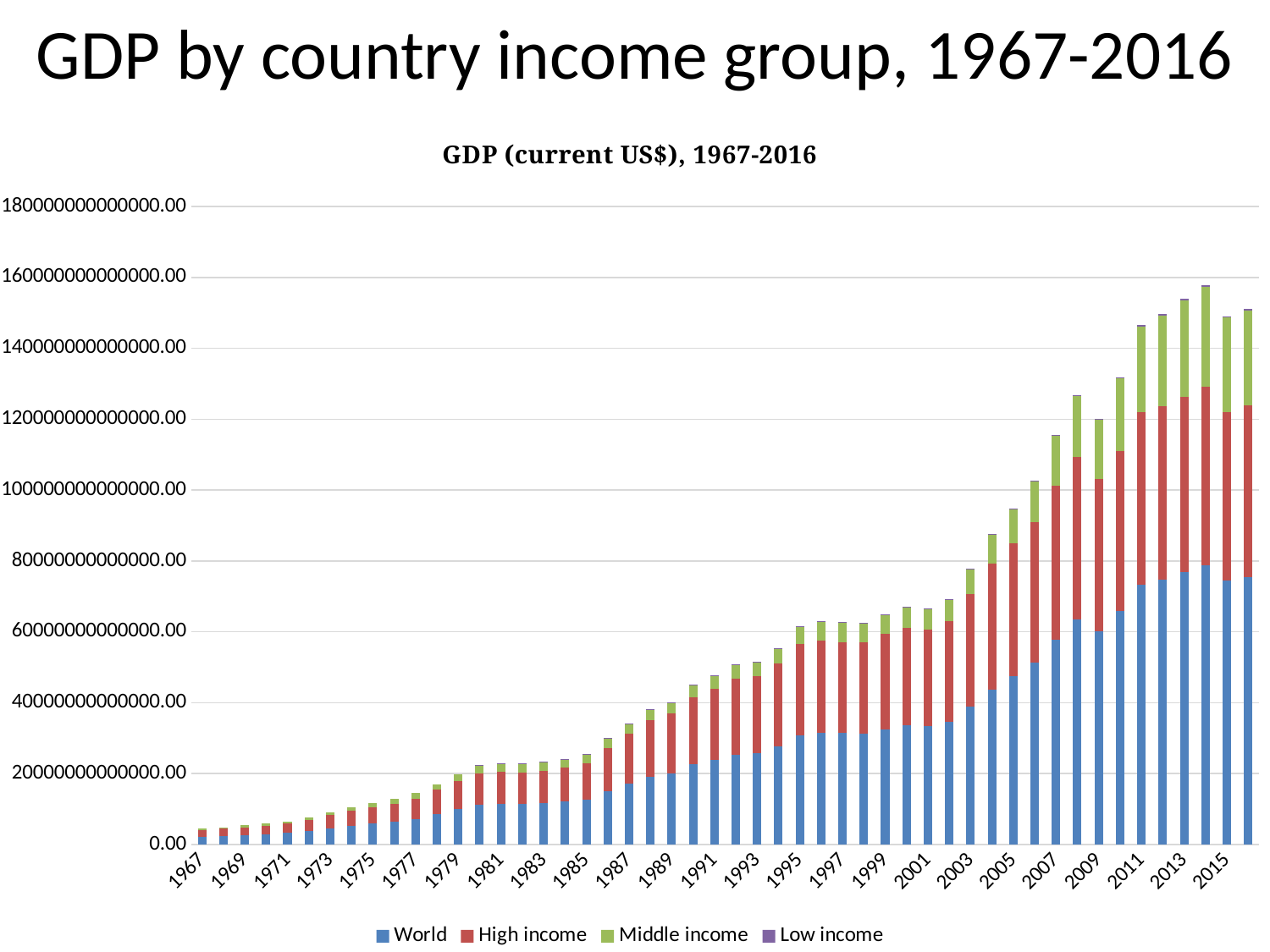
Which year has the tallest stacked bar? 2014 Which colour represents the World series in the chart? Blue Which year has the taller stacked bar, 2008 or 2009? 2008 Is the total stacked bar for 1967 greater or less than 200000000000000.00? less Which year has the taller stacked bar, 2014 or 2015? 2014 How many series does the legend list? 4 Which year has the shortest stacked bar? 1967 Do the stacked bar totals generally rise or fall from 1967 to 2016? Rise What kind of chart is shown on the slide? Stacked bar chart Is the total stacked bar for 2014 greater or less than 1400000000000000.00? greater What is the title printed above the chart? GDP (current US$), 1967-2016 Is the World segment for 2016 greater or less than 800000000000000.00? less